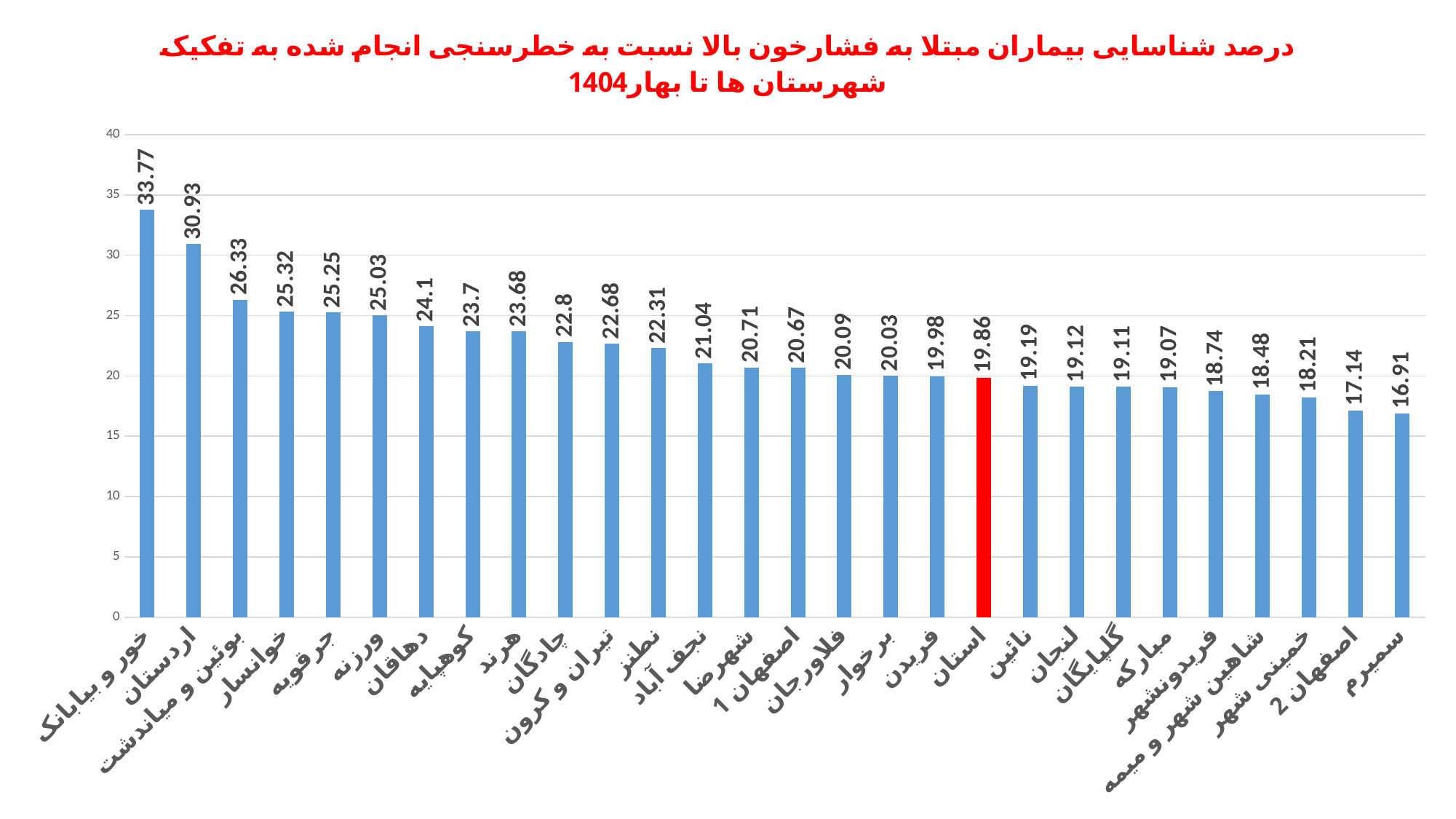
Which has a larger value, دهاقان or فریدونشهر? دهاقان Which category has the highest value? خور و بیابانک Do the values generally rise or fall from left to right along the x axis? fall What is the value for خور و بیابانک? 33.77 What is the difference between the values for اردستان and سمیرم? 14.02 What type of chart is shown on the slide? bar chart What is the value for استان (the red bar)? 19.86 How many bars are plotted in the chart? 28 Which category has the lowest value? سمیرم Which bar is highlighted in red? استان What is the value for نجف آباد? 21.04 Is the value for خوانسار greater or less than 20? greater